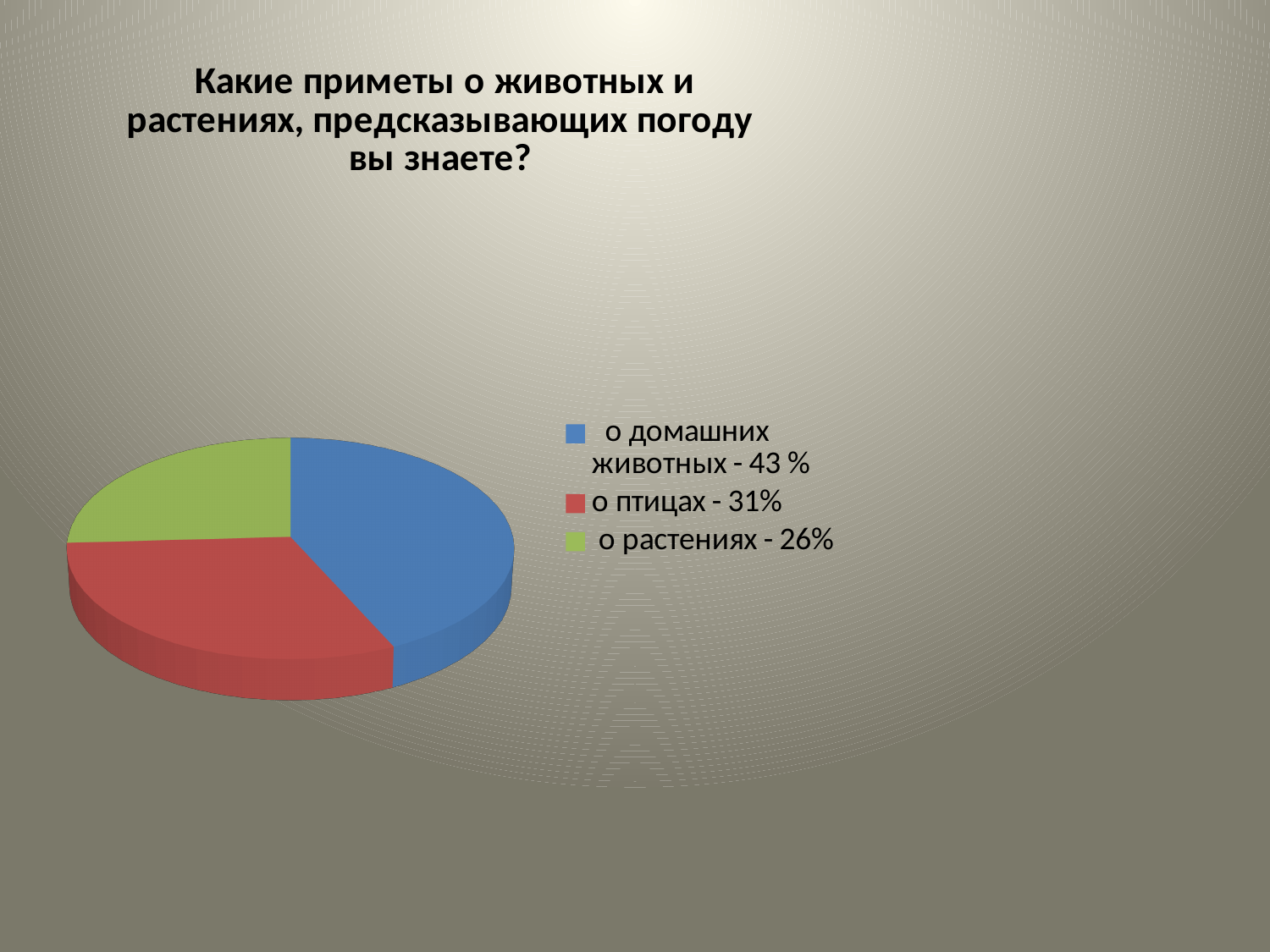
By how many percentage points does "о домашних животных" exceed "о птицах"? 12 What is the title of the chart on the slide? Какие приметы о животных и растениях, предсказывающих погоду вы знаете? What share of the pie is labelled "о растениях"? 26% What share of the pie is labelled "о птицах"? 31% How many slices does the pie chart have? 3 What kind of chart is shown on the slide? pie chart Which category has the largest slice of the pie? о домашних животных What colour is the slice for "о растениях"? green What share of the pie is labelled "о домашних животных"? 43 % By how many percentage points does "о птицах" exceed "о растениях"? 5 Which is larger: the slice for "о птицах" or the slice for "о растениях"? о птицах Which category has the smallest slice of the pie? о растениях